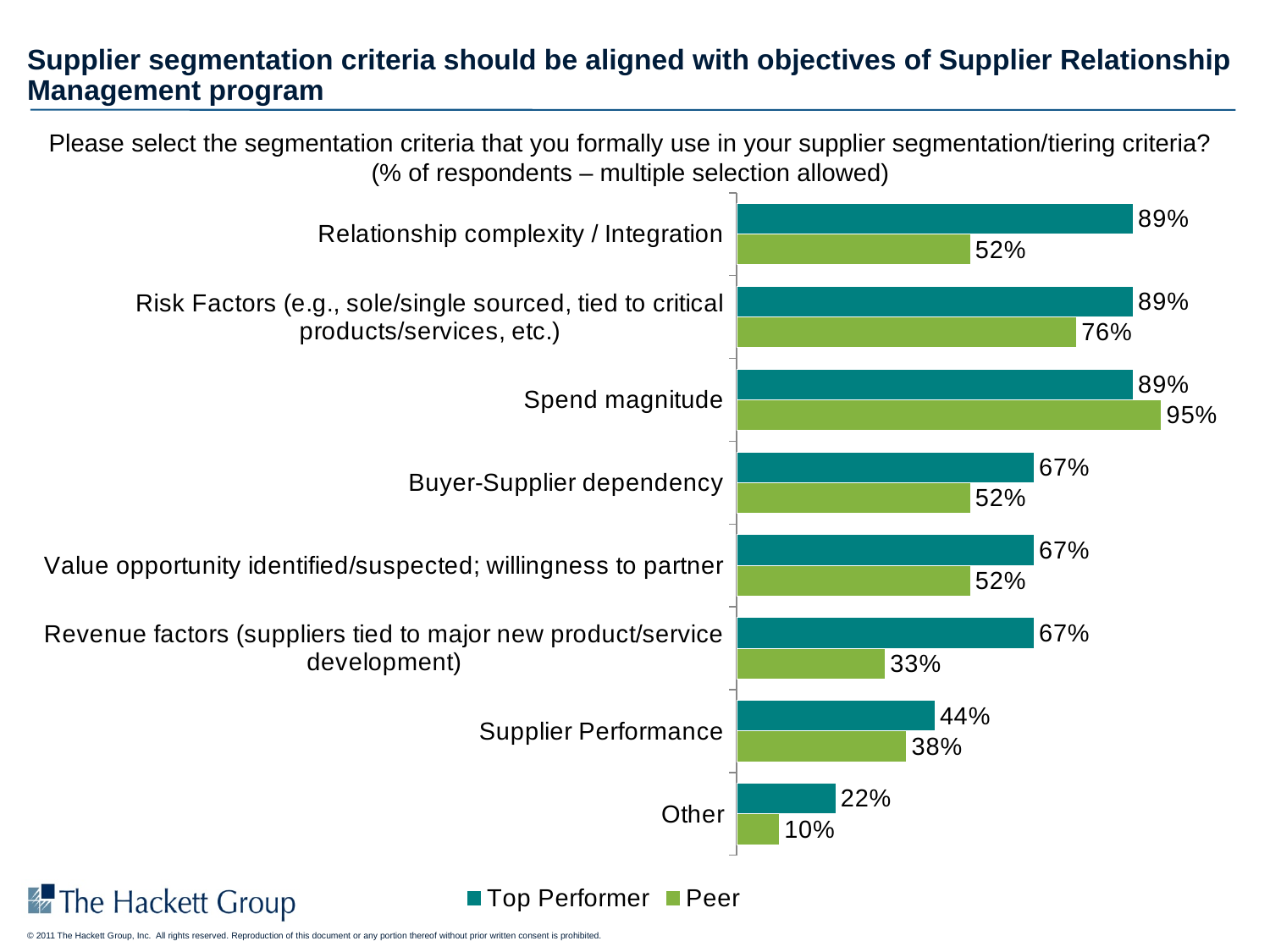
What is the Top Performer value for Spend magnitude? 89% What is the Peer value for Revenue factors (suppliers tied to major new product/service development)? 33% What is the Peer value for Spend magnitude? 95% What is the difference between the Top Performer and Peer values for Relationship complexity / Integration? 37% Which is larger for Spend magnitude, the Top Performer value or the Peer value? Peer Which category has the lowest Top Performer value? Other What kind of chart is shown on the slide? Bar chart How many categories are shown in the chart? 8 Which category has the highest Peer value? Spend magnitude What is the Top Performer value for Supplier Performance? 44% Which series is shown in green in the legend? Peer How many series does the legend list? 2